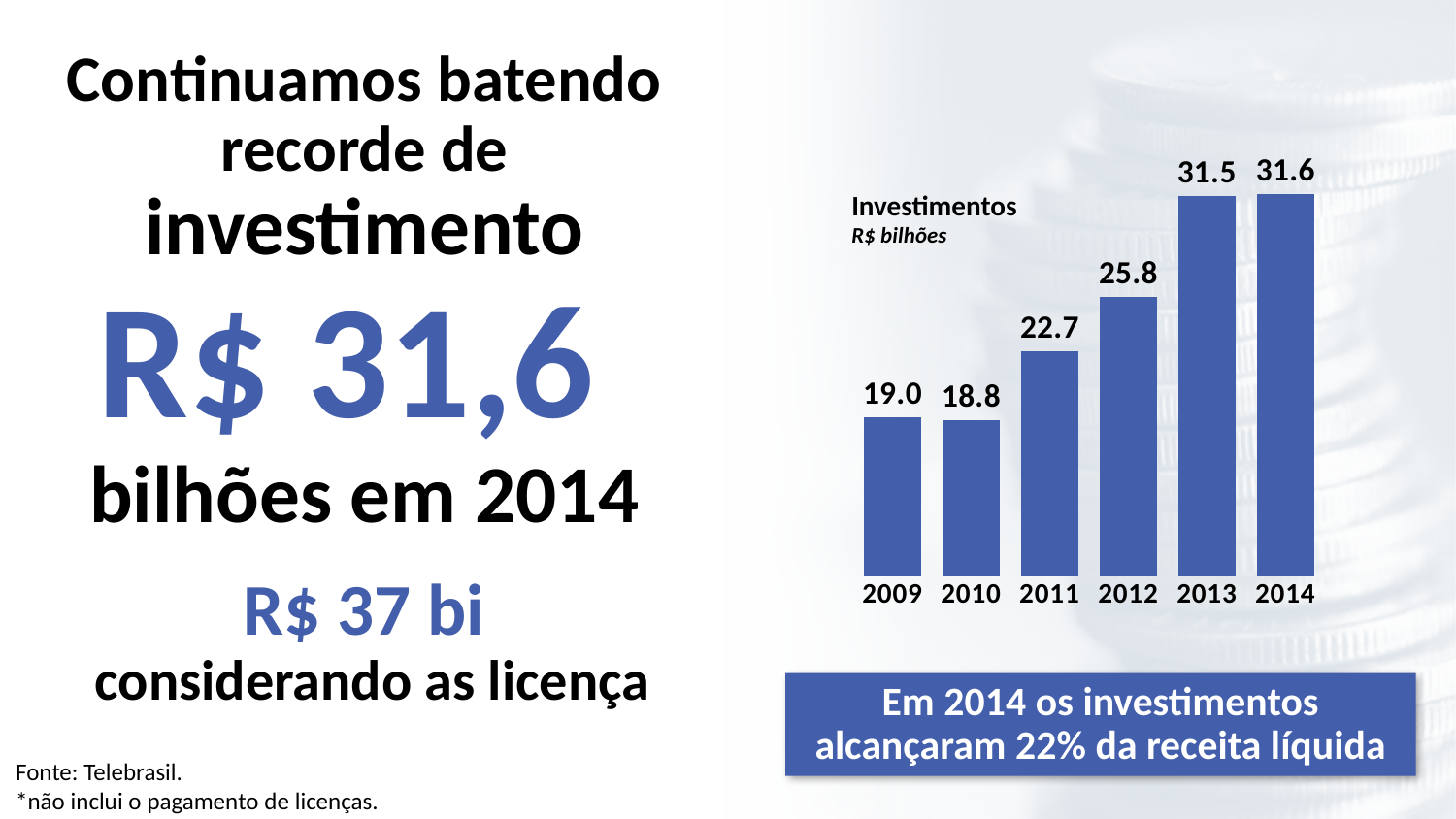
What is the difference between the investment values for 2013 and 2012? 5.7 What is the investment value for 2014? 31.6 Do the investment values generally rise or fall from 2010 to 2014? rise Which is larger, the investment value for 2009 or for 2010? 2009 How many years are shown in the chart? 6 What is the difference between the investment values for 2012 and 2011? 3.1 Which year has the lowest investment value? 2010 Which year has the highest investment value? 2014 What is the investment value for 2009? 19.0 What is the investment value for 2011? 22.7 What unit is stated under the chart title 'Investimentos'? R$ bilhões What kind of chart is shown on the slide? bar chart